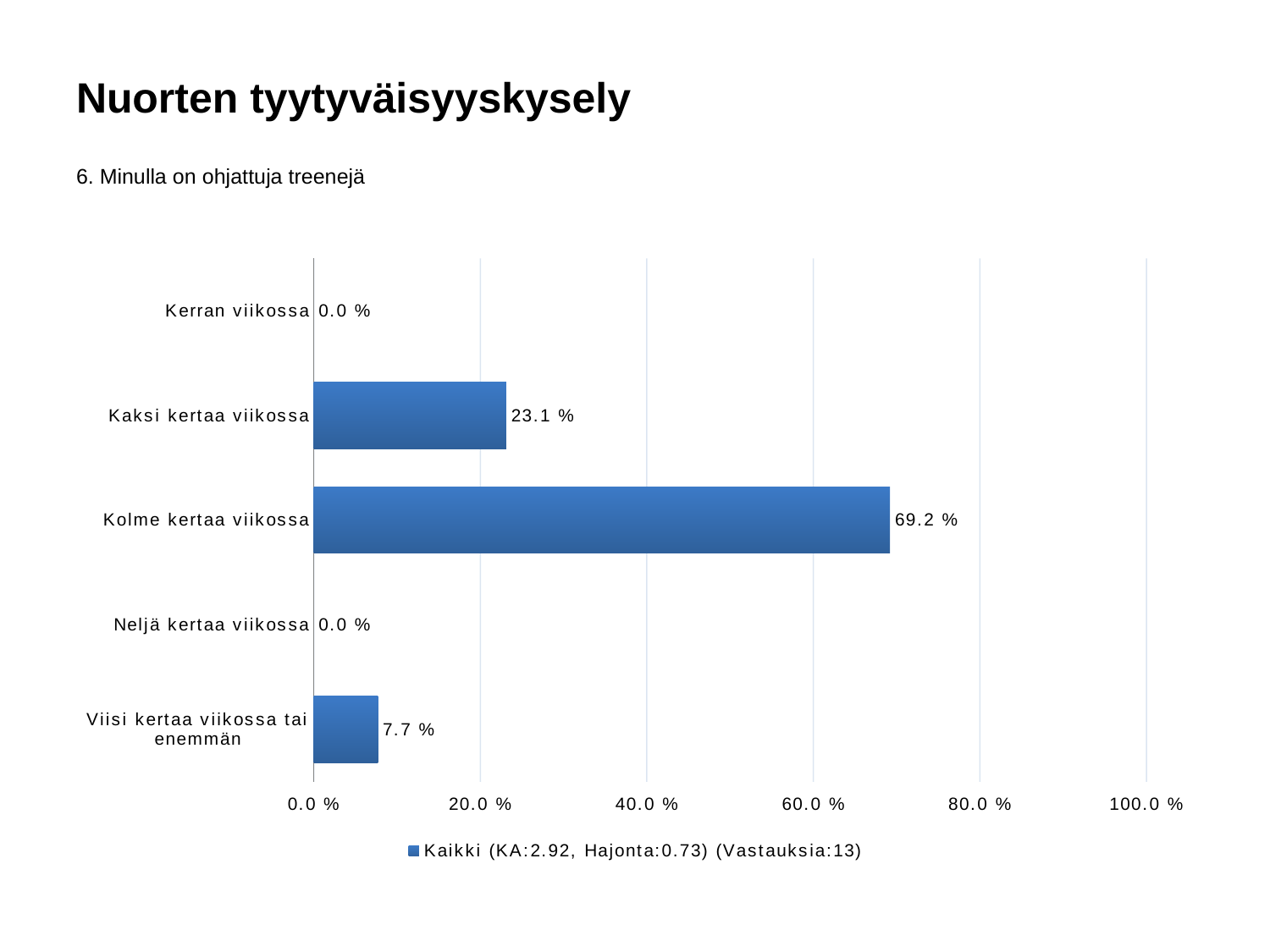
How many series does the legend list? 1 What is the value for "Viisi kertaa viikossa tai enemmän"? 7.7 % What is the difference between the values for "Kolme kertaa viikossa" and "Kaksi kertaa viikossa"? 46.1 % How many categories are shown on the chart? 5 What is the value for "Kolme kertaa viikossa"? 69.2 % Is the value for "Kolme kertaa viikossa" greater or less than 60.0 %? greater Which category has the highest value? Kolme kertaa viikossa What kind of chart is shown on the slide? bar chart Which is larger, the value for "Kaksi kertaa viikossa" or "Viisi kertaa viikossa tai enemmän"? Kaksi kertaa viikossa How many responses (Vastauksia) does the legend report? 13 What is the value for "Kaksi kertaa viikossa"? 23.1 % What is the value for "Neljä kertaa viikossa"? 0.0 %